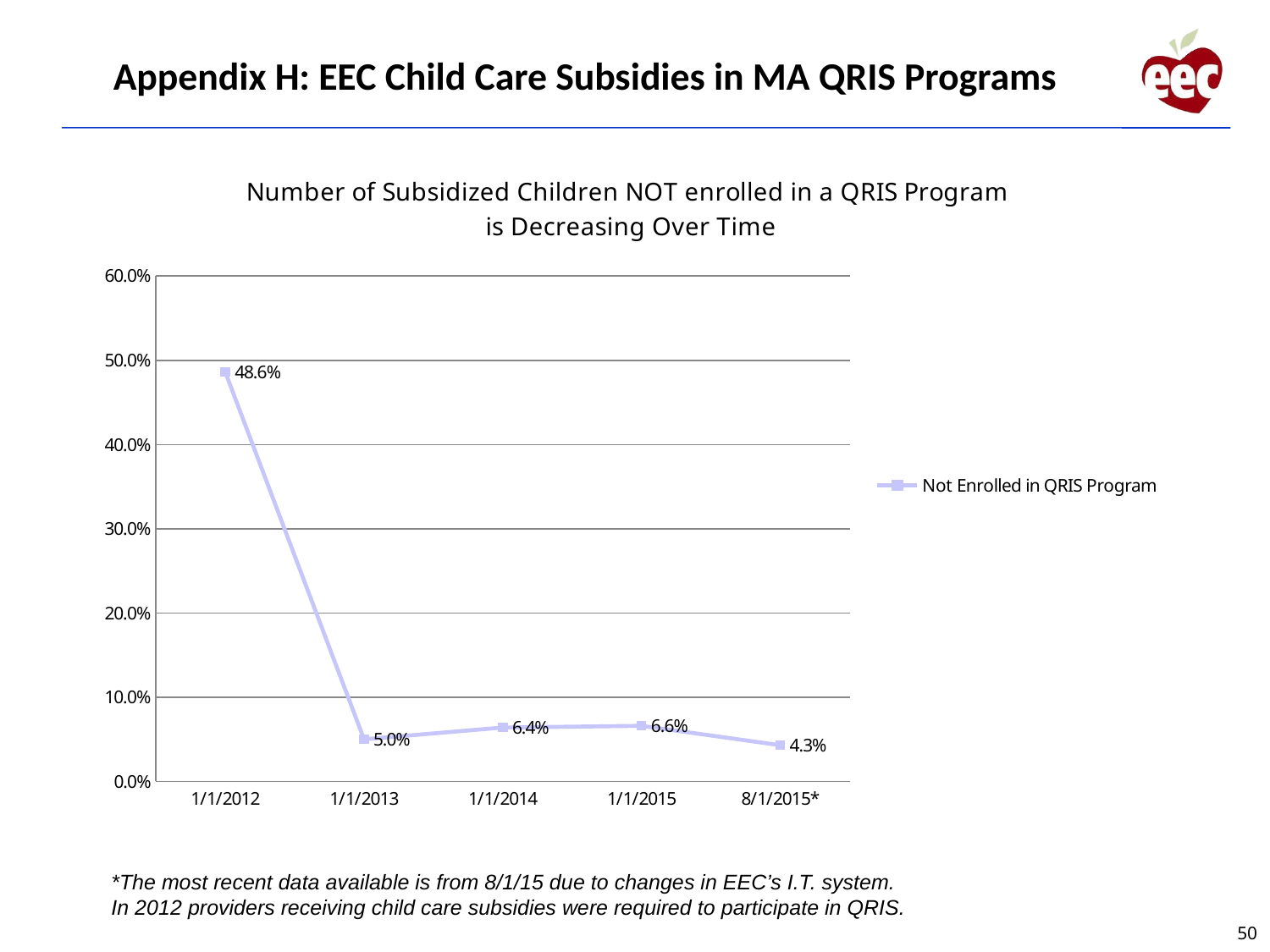
What kind of chart is this? line chart Which date has the highest value? 1/1/2012 What is the name of the series shown in the legend? Not Enrolled in QRIS Program What is the value for 8/1/2015*? 4.3% Which date has the lowest value? 8/1/2015* What is the difference between the values for 1/1/2012 and 1/1/2013? 43.6% How many dates are plotted on the x axis? 5 What is the value for 1/1/2013? 5.0% Is the value for 1/1/2012 greater or less than 40.0%? greater How many series does the legend list? 1 What is the value for 1/1/2012? 48.6% Which is larger, the value for 1/1/2014 or the value for 8/1/2015*? 1/1/2014